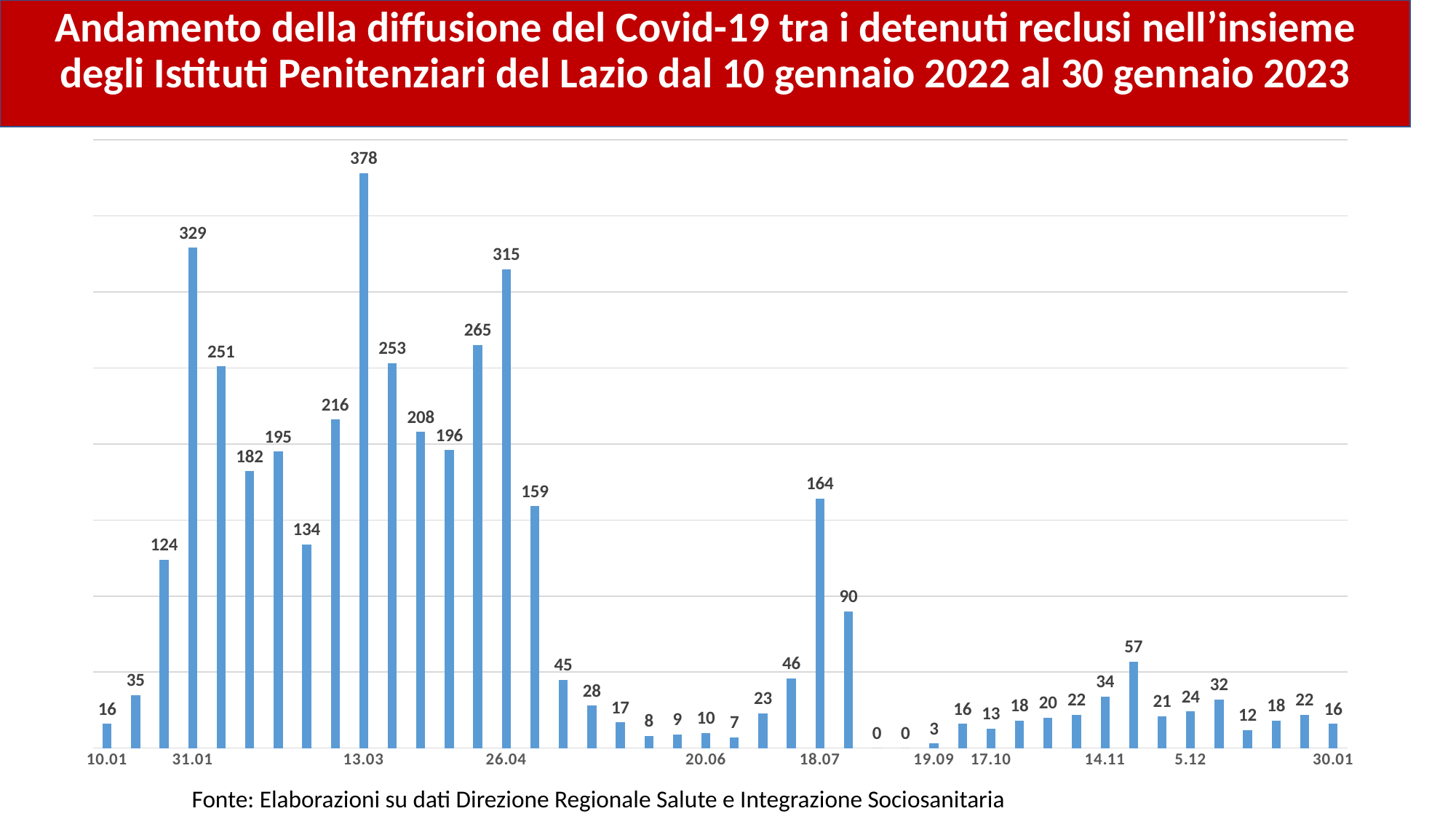
Which date has the highest value in the chart? 13.03 What source is cited below the chart? Elaborazioni su dati Direzione Regionale Salute e Integrazione Sociosanitaria What is the value for 18.07? 164 What is the difference between the value for 13.03 and the value for 31.01? 49 What is the value for 30.01? 16 What is the value for 10.01? 16 What is the lowest value shown in the chart? 0 What kind of chart is shown on the slide? bar chart How many bars are plotted in the chart? 44 What is the highest value shown in the chart? 378 What is the value for 26.04? 315 Which is larger, the value for 31.01 or the value for 26.04? 31.01